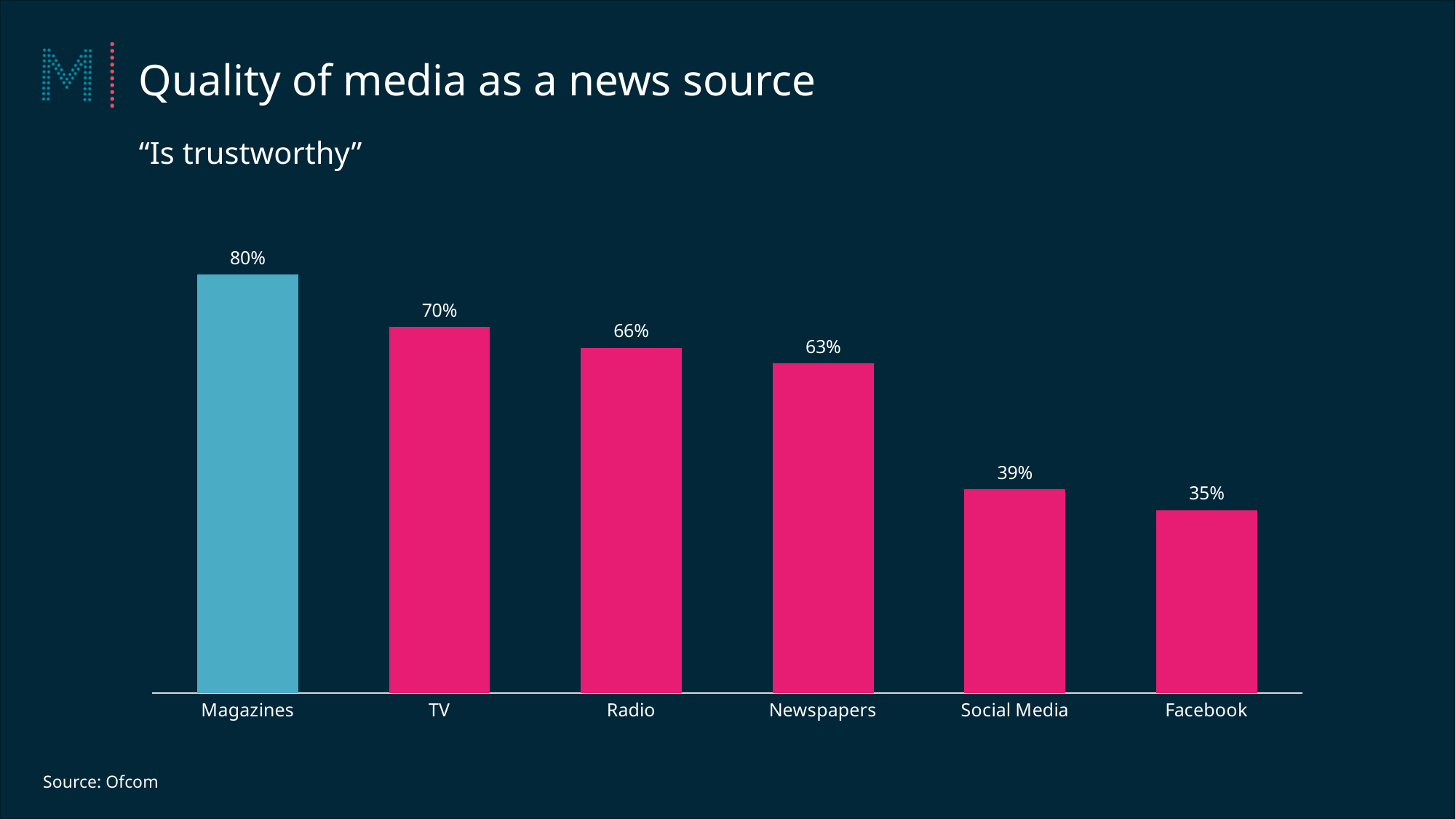
Which media source has the lowest trustworthiness value? Facebook What kind of chart is shown on the slide? Bar chart Which bar is coloured differently from the others? Magazines What is the value shown for Social Media? 39% What percentage of respondents rated Magazines as trustworthy? 80% What is the value shown for Radio? 66% Which media source has the highest trustworthiness value? Magazines Which has a higher value, Radio or Social Media? Radio What is the difference between the values for TV and Newspapers? 7% What is the difference between the values for Magazines and Facebook? 45% How many media sources are shown on the chart? 6 Do the values rise or fall from left to right across the chart? Fall